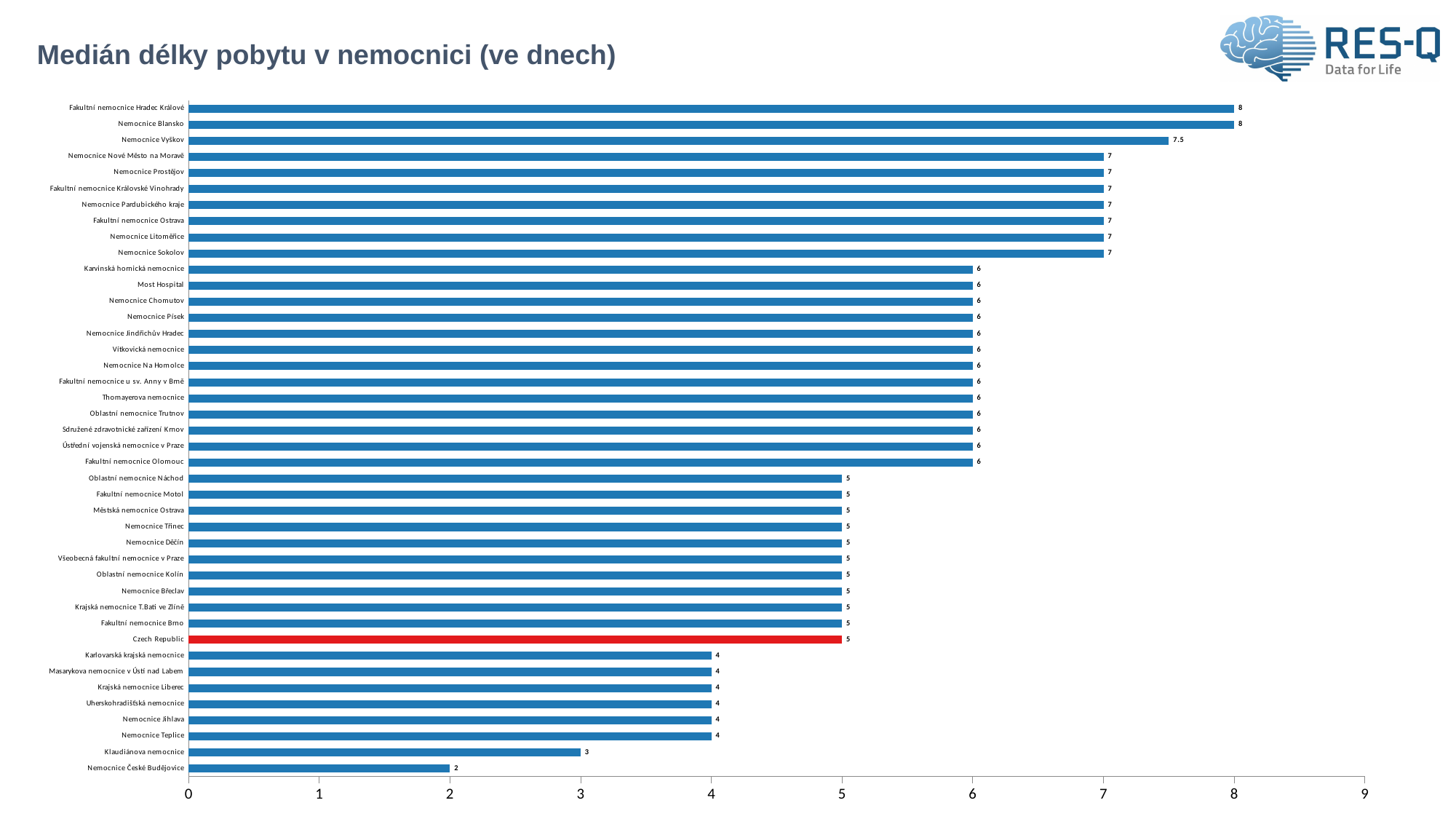
What is the difference between the values for Nemocnice Vyškov and Czech Republic? 2.5 What is the value shown for Klaudiánova nemocnice? 3 Which hospital has the lowest median length of stay? Nemocnice České Budějovice Is the value for Nemocnice Blansko greater or less than 6? greater Which has a higher value, Nemocnice Sokolov or Nemocnice Teplice? Nemocnice Sokolov What is the value shown for Czech Republic? 5 What is the difference between the values for Fakultní nemocnice Hradec Králové and Nemocnice České Budějovice? 6 What is the value shown for Fakultní nemocnice Motol? 5 How many hospitals/categories are shown in the chart? 42 What type of chart is shown on the slide? Bar chart What is the median length of hospital stay for Nemocnice Vyškov? 7.5 Which bar is highlighted in red? Czech Republic